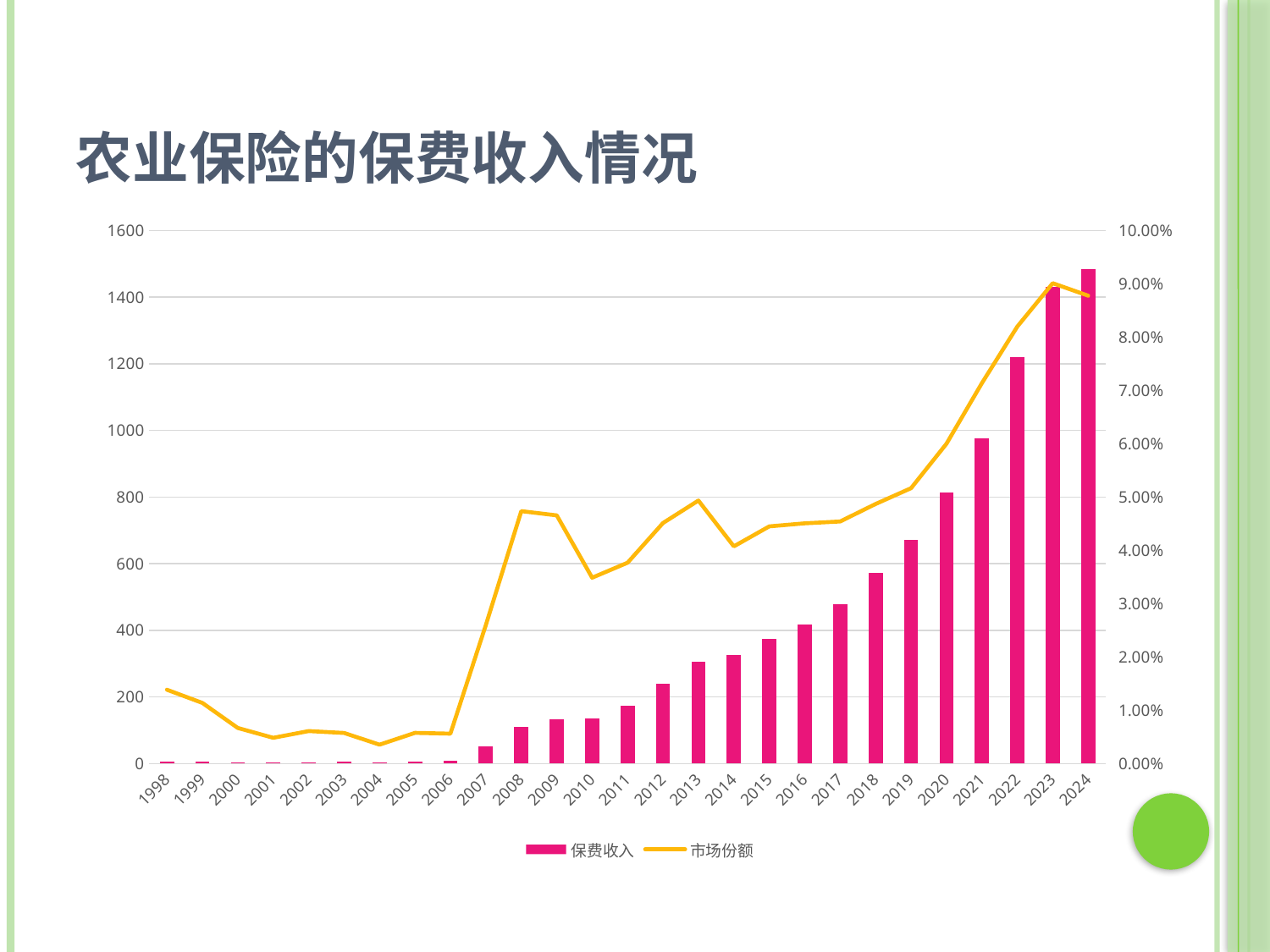
Is the 保费收入 value for 2015 greater or less than 400? less Which year has the highest 保费收入 bar? 2024 Is the 保费收入 value for 2019 greater or less than 600? greater Do the 保费收入 bars rise or fall from 2007 to 2024? rise What kind of chart is shown on the slide? A combination bar and line chart Which is larger, the 保费收入 bar for 2022 or for 2023? 2023 Is the 市场份额 value for 2010 greater or less than 4.00%? less Which year has the lowest 市场份额 value on the line? 2004 How many series does the legend list? 2 How many years are shown on the x axis? 27